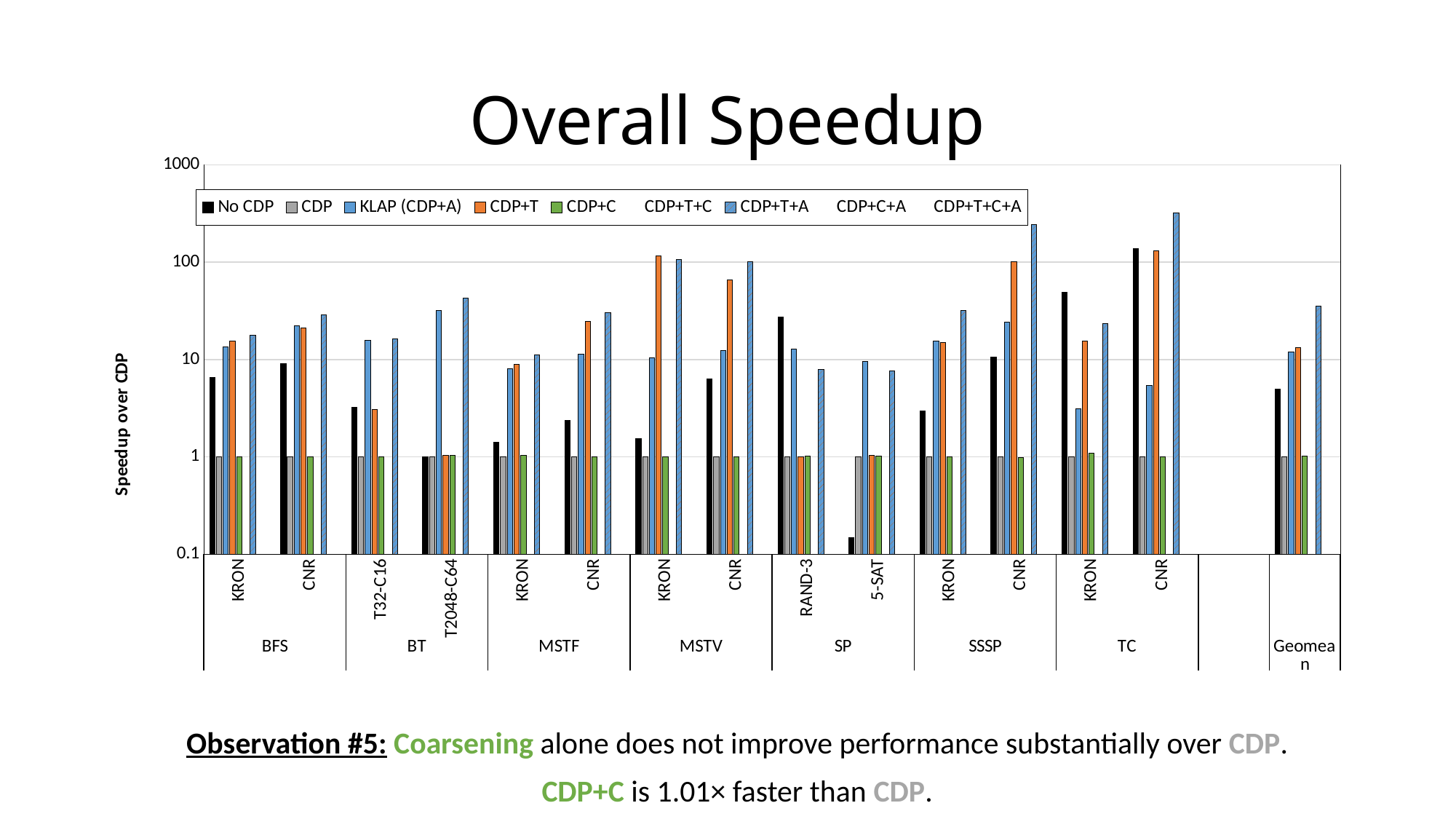
What is the label on the vertical axis? Speedup over CDP What is the title of the chart? Overall Speedup Is the CDP+T+A value for SSSP CNR greater or less than 100? greater How many labeled benchmark groups are shown along the x axis? 8 What kind of chart is shown on the slide? bar chart Is the No CDP value for BFS KRON greater or less than 10? less How many series does the legend list? 9 What is the CDP value for Geomean? 1 For TC CNR, which is larger: the No CDP value or the KLAP (CDP+A) value? No CDP Is the No CDP value for TC CNR greater or less than 100? greater